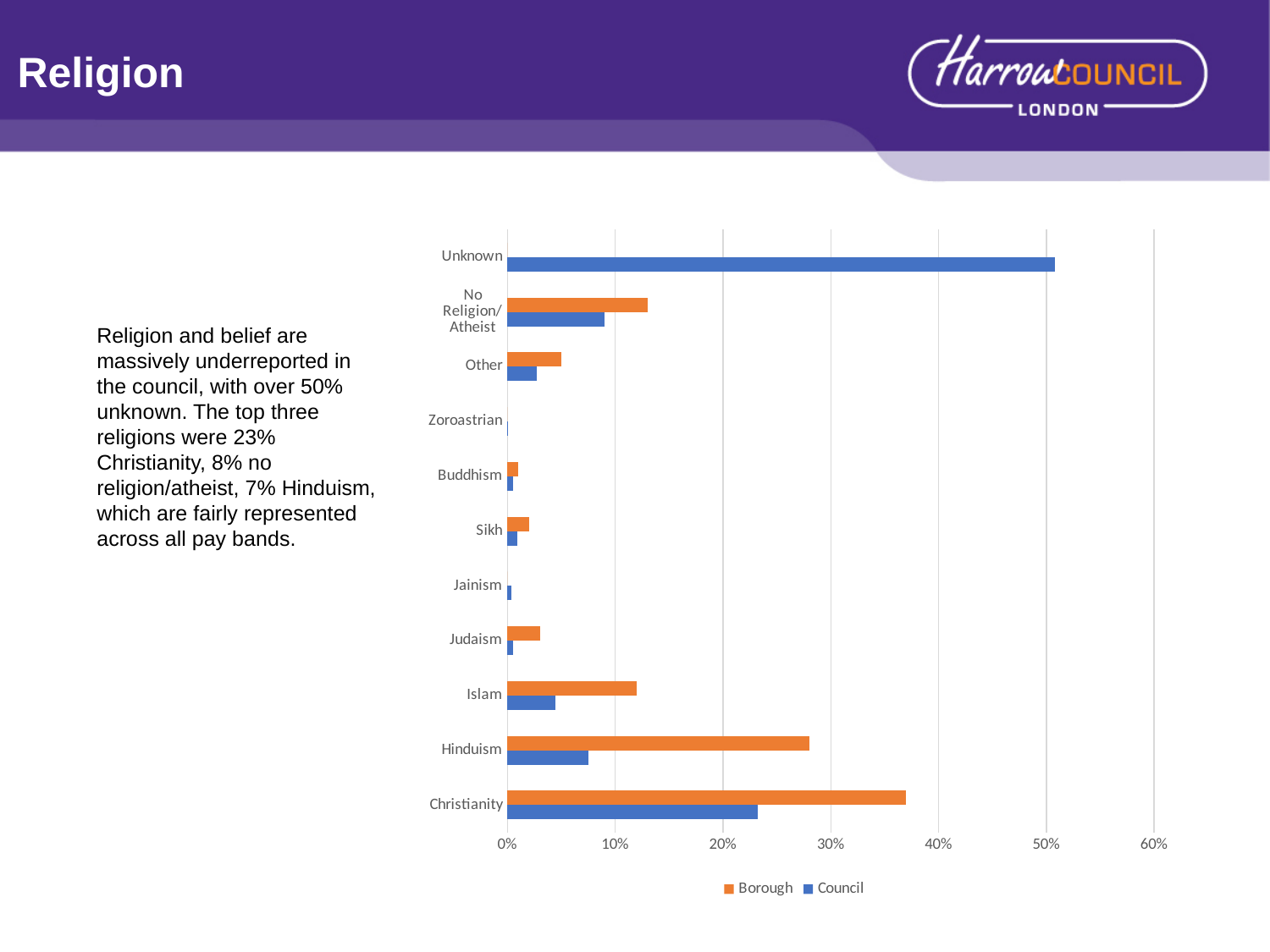
Is the Borough value for Hinduism greater or less than 20%? greater Which category has the highest Borough value? Christianity Which category has the highest Council value? Unknown Which series is shown in orange in the legend? Borough Is the Borough value for Christianity greater or less than 30%? greater For Hinduism, which is larger: the Borough value or the Council value? Borough Is the Council value for Christianity greater or less than 30%? less What kind of chart is shown on the slide? bar chart How many religion categories are shown on the chart? 11 How many series does the legend list? 2